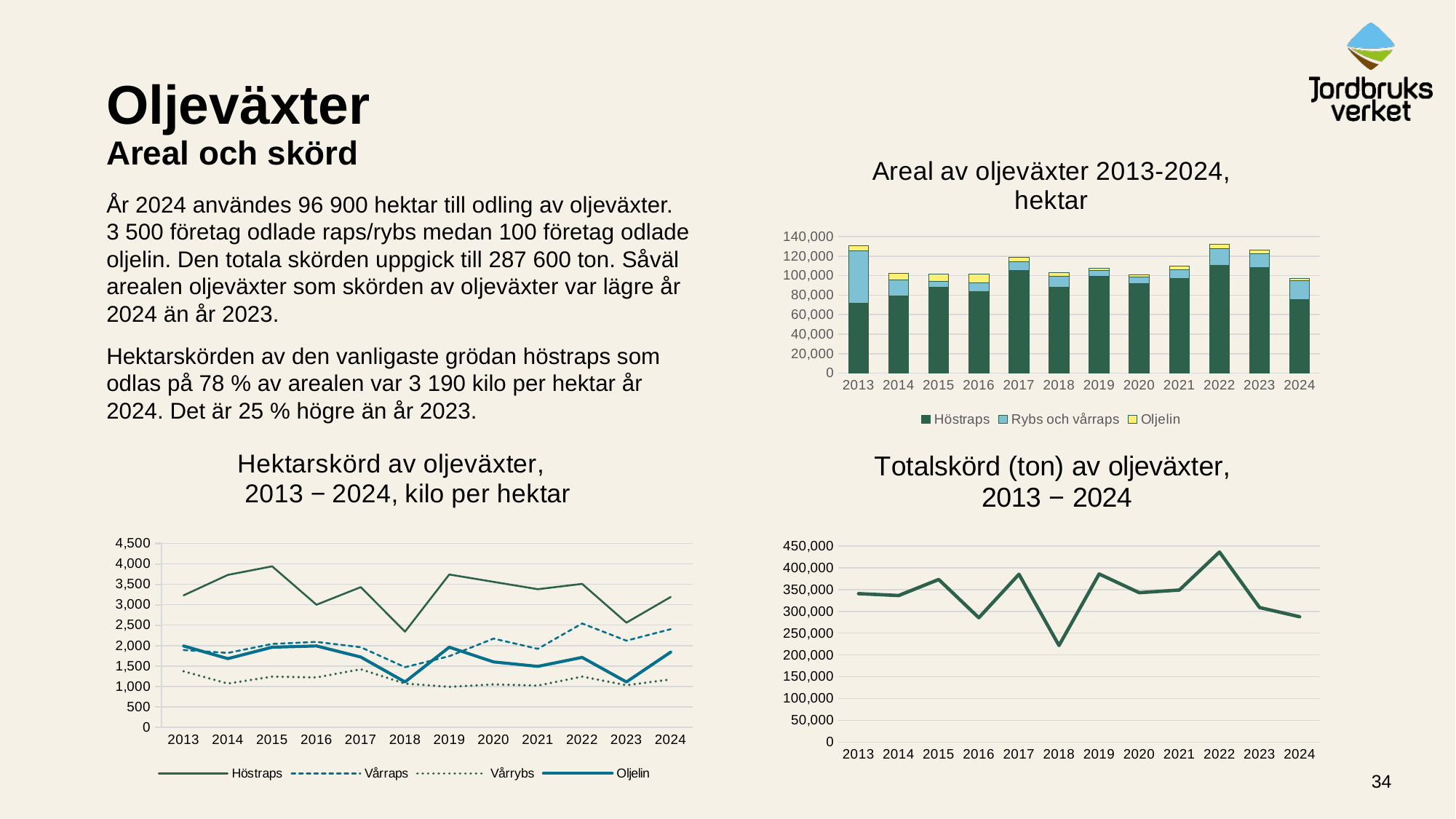
In the 'Totalskörd (ton) av oljeväxter, 2013 − 2024' chart, which year has the highest value? 2022 What kind of chart is the 'Areal av oljeväxter 2013-2024, hektar' chart? bar chart How many series does the legend of the 'Areal av oljeväxter 2013-2024, hektar' chart list? 3 In the 'Totalskörd (ton) av oljeväxter, 2013 − 2024' chart, is the value for 2018 greater or less than 250,000? less In the 'Areal av oljeväxter 2013-2024, hektar' chart, is the 'Höstraps' value for 2013 greater or less than 80,000? less In the 'Areal av oljeväxter 2013-2024, hektar' chart, in which year is the 'Rybs och vårraps' segment largest? 2013 In the 'Areal av oljeväxter 2013-2024, hektar' chart, is the total bar for 2022 greater or less than 120,000? greater In the 'Hektarskörd av oljeväxter, 2013 − 2024, kilo per hektar' chart, in which year is the 'Höstraps' value lowest? 2018 In the 'Hektarskörd av oljeväxter, 2013 − 2024, kilo per hektar' chart, which is larger in 2024, 'Höstraps' or 'Vårrybs'? Höstraps What kind of chart is the 'Totalskörd (ton) av oljeväxter, 2013 − 2024' chart? line chart How many series does the legend of the 'Hektarskörd av oljeväxter, 2013 − 2024, kilo per hektar' chart list? 4